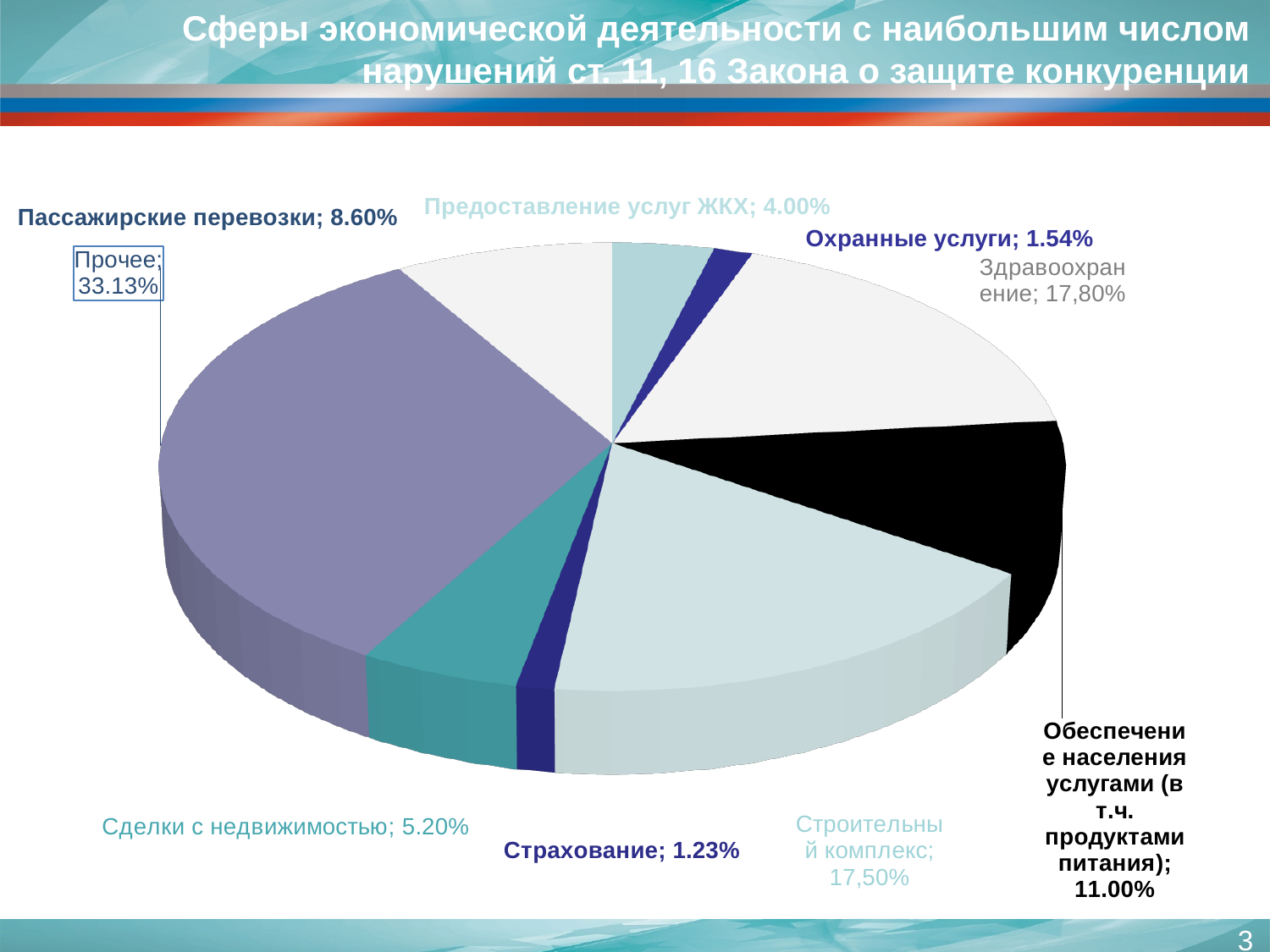
What type of chart is shown on the slide? Pie chart What is the value shown for Обеспечение населения услугами (в т.ч. продуктами питания)? 11.00% What is the value shown for Здравоохранение? 17,80% Which category has the smallest share of the pie? Страхование What share of the pie does Прочее account for? 33.13% What is the value shown for Пассажирские перевозки? 8.60% Which category has the largest share of the pie? Прочее What is the title of the slide containing the chart? Сферы экономической деятельности с наибольшим числом нарушений ст. 11, 16 Закона о защите конкуренции Which is larger, Здравоохранение or Строительный комплекс? Здравоохранение How many categories (slices) does the pie chart show? 9 What is the value shown for Строительный комплекс? 17,50% What is the difference between the values for Пассажирские перевозки and Сделки с недвижимостью? 3.40%